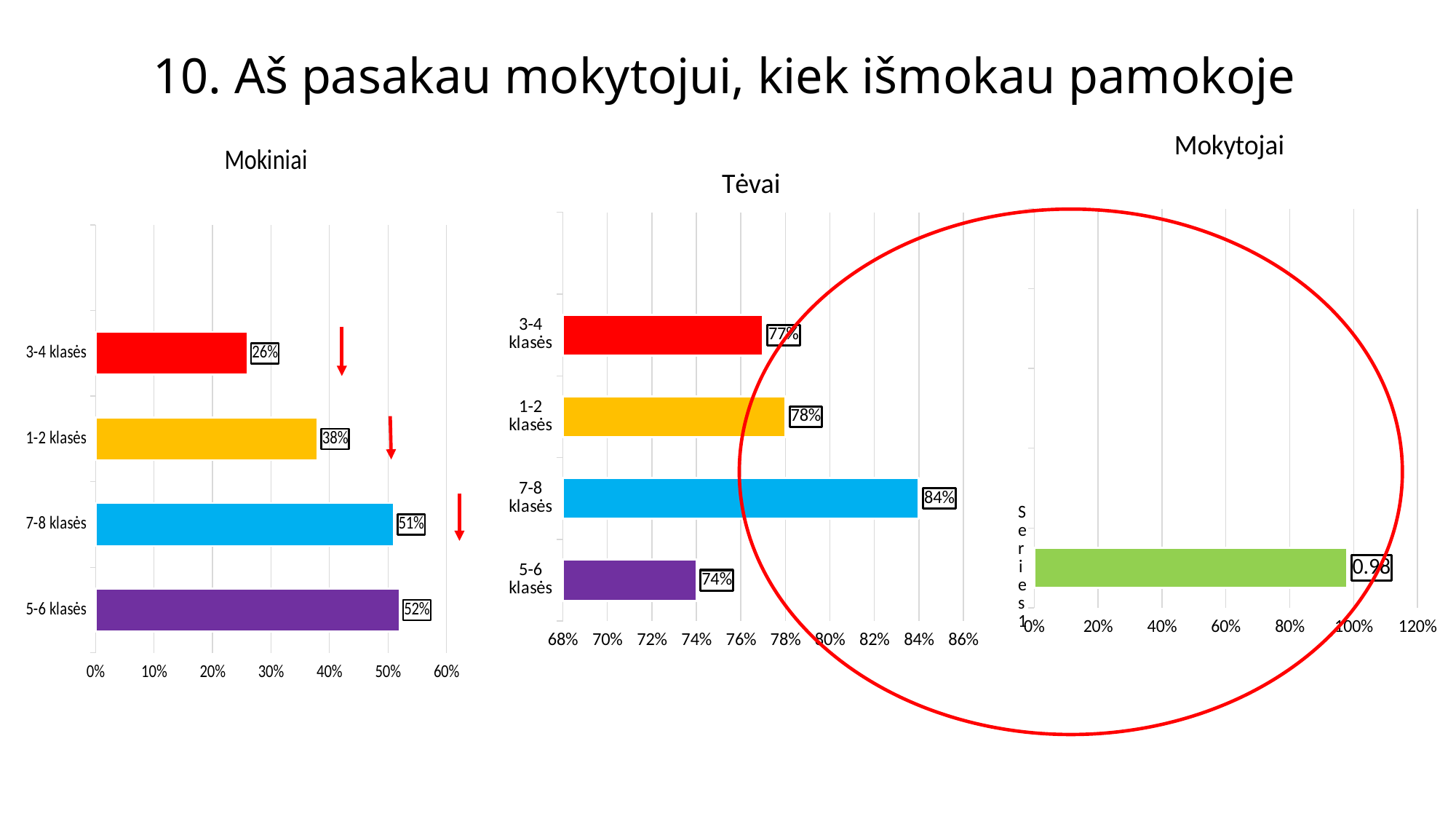
In the Mokiniai chart, what is the value for 7-8 klasės? 51% How many categories does the Mokiniai chart show? 4 In the Tėvai chart, what is the value for 5-6 klasės? 74% In the Mokytojai chart, what is the value shown on the bar? 0.98 In the Tėvai chart, which category has the highest value? 7-8 klasės In the Tėvai chart, which category has the lowest value? 5-6 klasės In the Tėvai chart, which is larger: the value for 1-2 klasės or the value for 3-4 klasės? 1-2 klasės In the Mokiniai chart, what is the difference between the values for 5-6 klasės and 1-2 klasės? 14% In the Mokiniai chart, what is the value for 3-4 klasės? 26% In the Mokiniai chart, which category has the lowest value? 3-4 klasės What kind of chart is the Tėvai chart? bar chart In the Tėvai chart, what is the value for 7-8 klasės? 84%